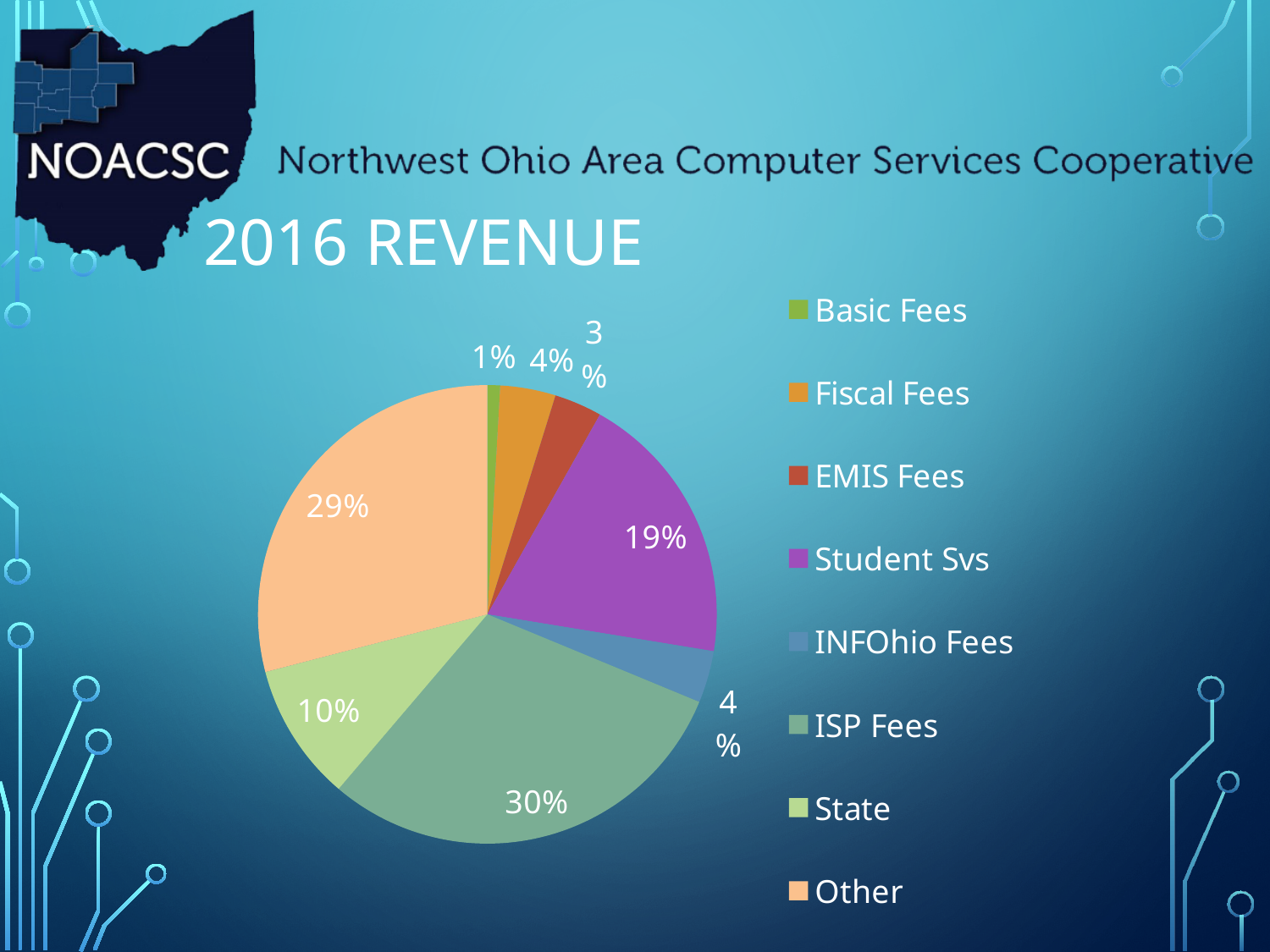
What share of 2016 revenue comes from ISP Fees? 30% What percentage of 2016 revenue comes from State? 10% What is the difference in percentage points between ISP Fees and Student Svs? 11 Which revenue category has the largest share of the pie? ISP Fees What percentage of 2016 revenue is labelled Other? 29% How many categories does the pie chart have? 8 What kind of chart is shown on the slide? pie chart Which is larger, the share for Other or the share for State? Other Which revenue category has the smallest share of the pie? Basic Fees What share of 2016 revenue comes from Student Svs? 19% What is the title of the chart? 2016 REVENUE What percentage of 2016 revenue comes from EMIS Fees? 3%